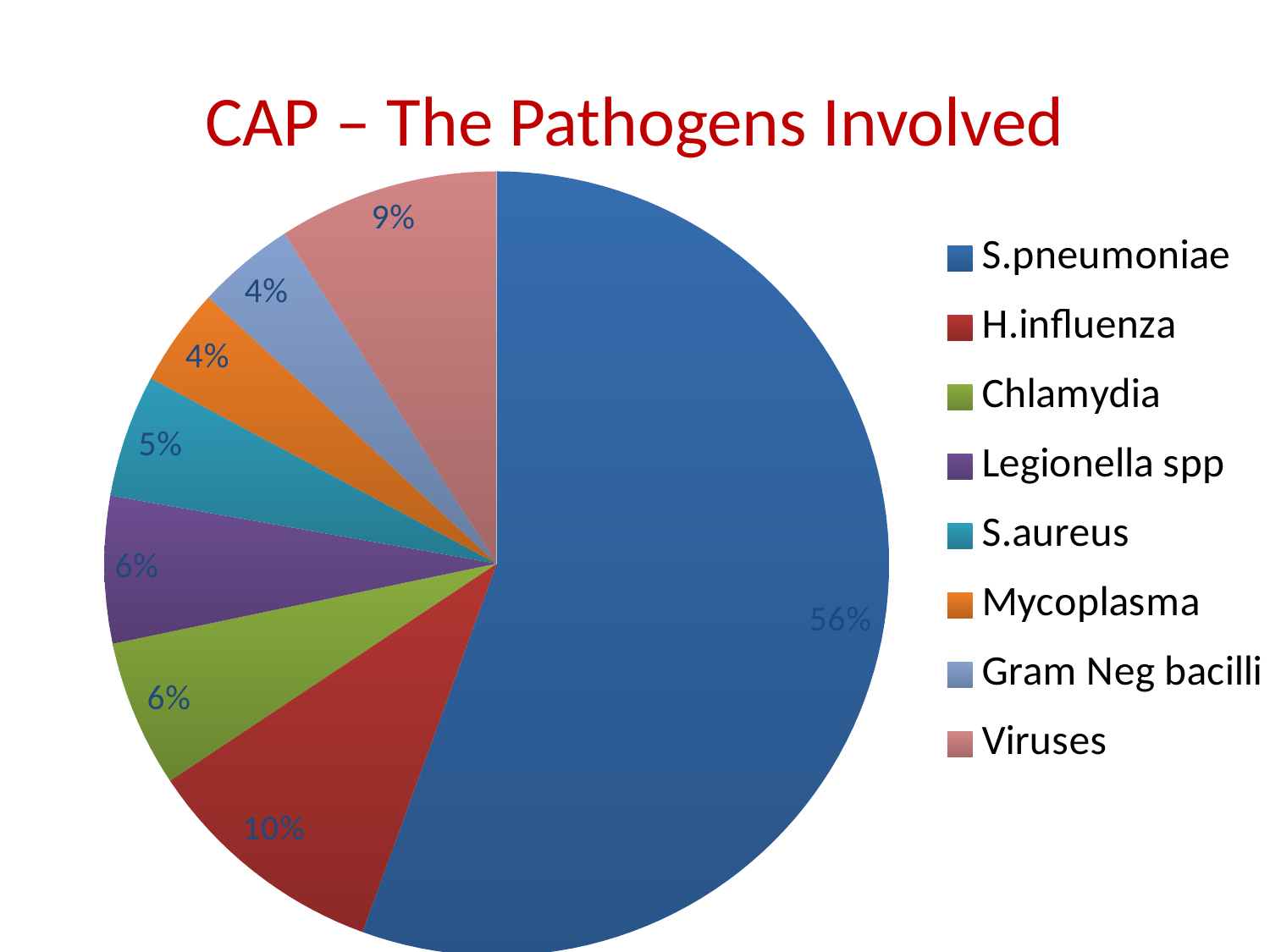
What kind of chart is shown on the slide? pie chart How many categories does the legend list? 8 What is the difference between the Viruses share and the Mycoplasma share? 5% What percentage is shown for Viruses? 9% Which pathogen has the largest slice of the pie? S.pneumoniae Which colour represents Chlamydia in the chart? green What percentage is shown for S.aureus? 5% What is the title of the chart? CAP – The Pathogens Involved Which is larger, the share for Viruses or the share for Legionella spp? Viruses What share of the pie does S.pneumoniae account for? 56% What percentage is shown for H.influenza? 10% What is the difference between the S.pneumoniae share and the H.influenza share? 46%